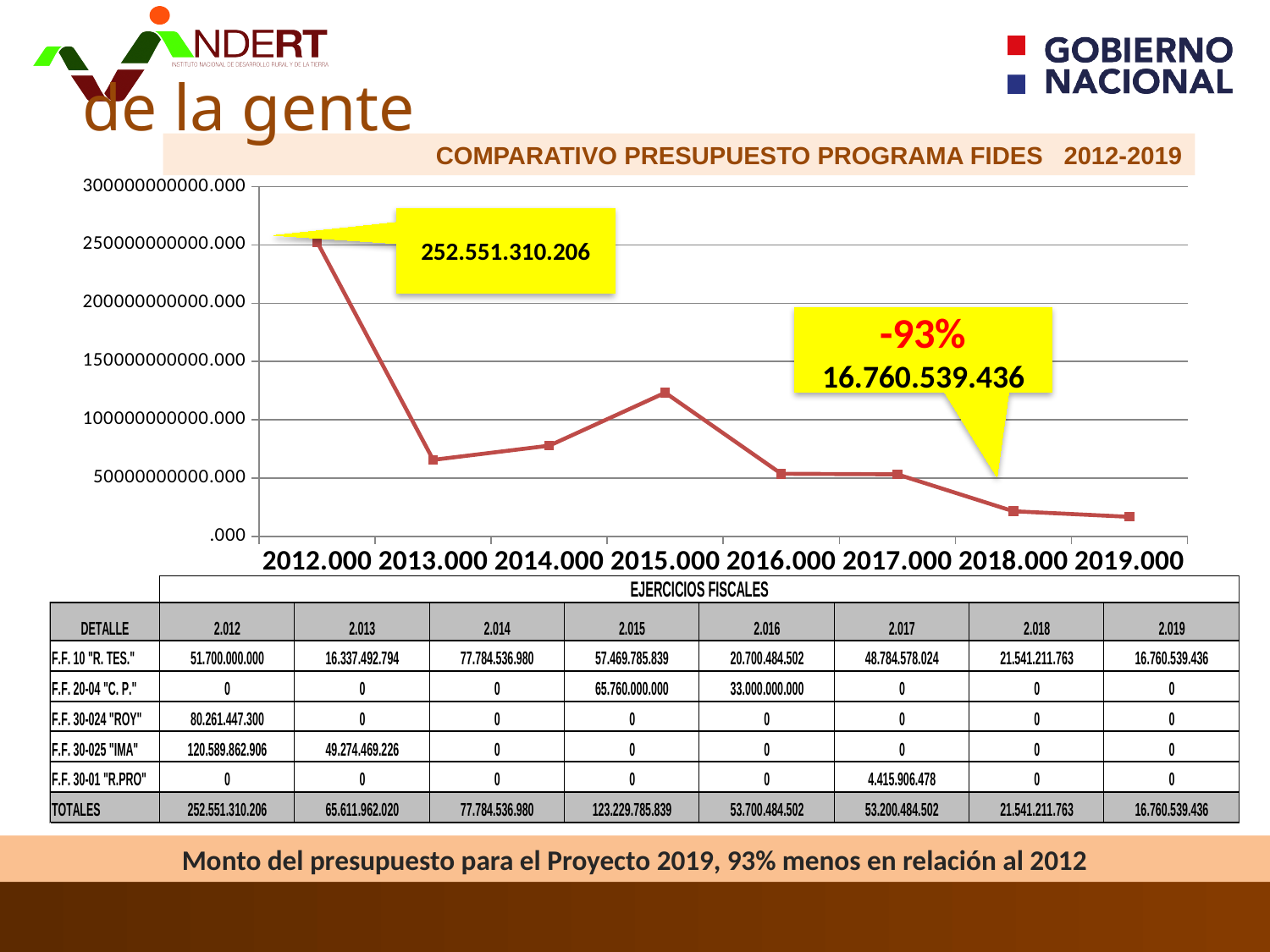
What is the difference between the 2012 value and the 2019 value shown in the chart callouts? 235.790.770.770 Which year has the lowest value on the chart? 2019 What value does the callout give for the 2019 point on the chart? 16.760.539.436 Is the value for 2015 on the chart greater or less than 100000000000.000? greater Do the values on the chart rise or fall from 2015 to 2019? fall Which year has the larger value on the chart, 2014 or 2015? 2015 What kind of chart is shown on the slide? line chart How many fiscal years are plotted on the x axis of the chart? 8 Which year has the highest value on the chart? 2012 Is the value for 2013 on the chart greater or less than 100000000000.000? less What value does the callout give for the 2012 point on the chart? 252.551.310.206 What percentage change is shown in the callout near the 2019 point? -93%